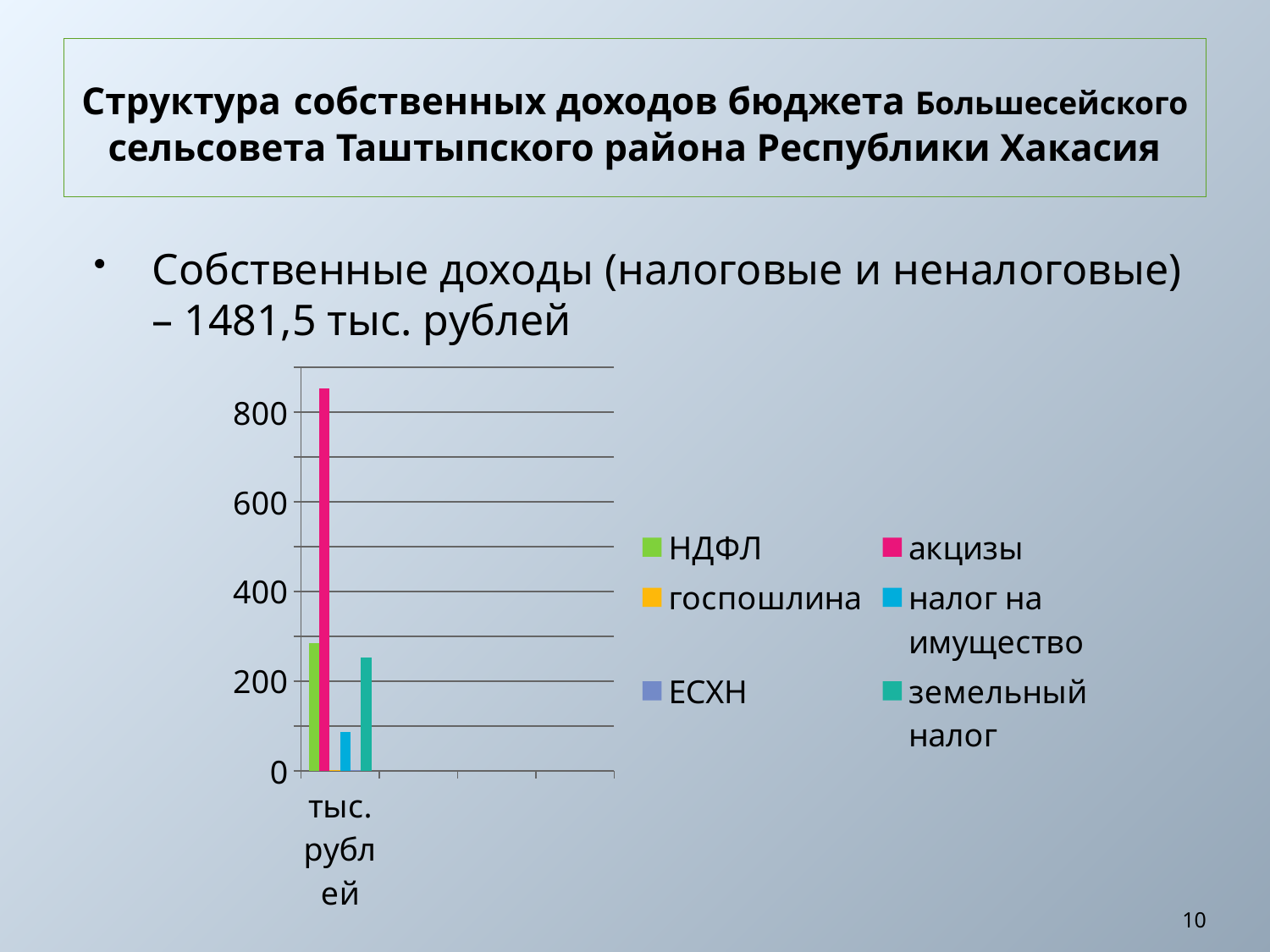
Is the value for НДФЛ greater or less than 200? greater Which series has the tallest bar? акцизы What colour is the bar for акцизы? pink Is the value for НДФЛ greater or less than 400? less Which is larger, the value for НДФЛ or the value for земельный налог? НДФЛ What kind of chart is shown on the slide? bar chart What is the highest value shown on the vertical axis? 800 Is the value for земельный налог greater or less than 200? greater Which is larger, the value for акцизы or the value for налог на имущество? акцизы How many series does the legend list? 6